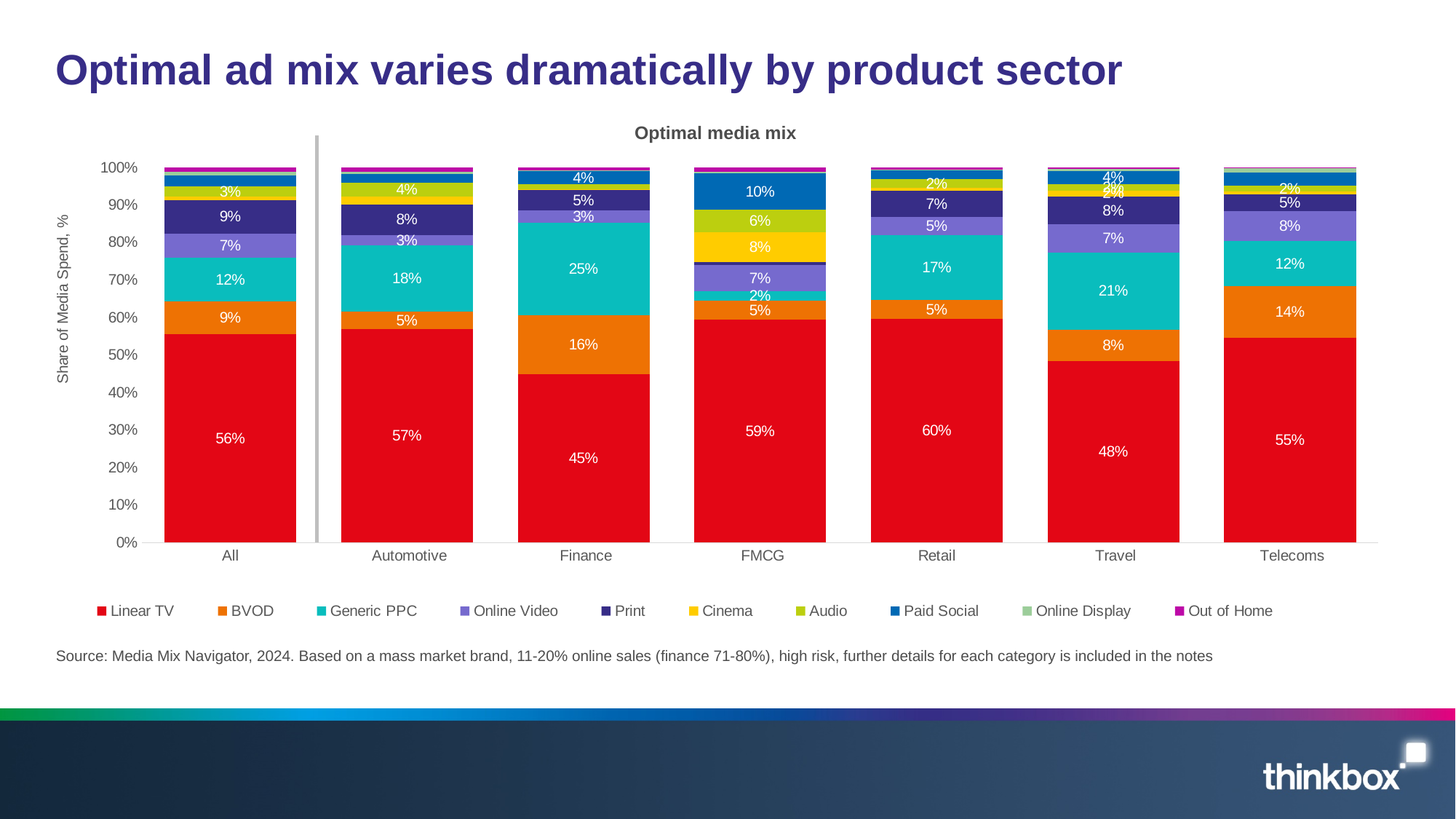
How many percentage points higher is the Generic PPC share for Finance than for All? 13 percentage points How many sectors (categories) are shown on the x axis? 7 Which has a larger BVOD share, Finance or Automotive? Finance What is the BVOD share for Telecoms? 14% How many series does the legend list? 10 What is the Linear TV share of media spend for the Finance sector? 45% Which sector has the highest Linear TV share? Retail What is the Paid Social share for FMCG? 10% What kind of chart is shown on the slide? Stacked bar chart What is the Generic PPC share for the Travel sector? 21% Which sector has the lowest Linear TV share? Finance